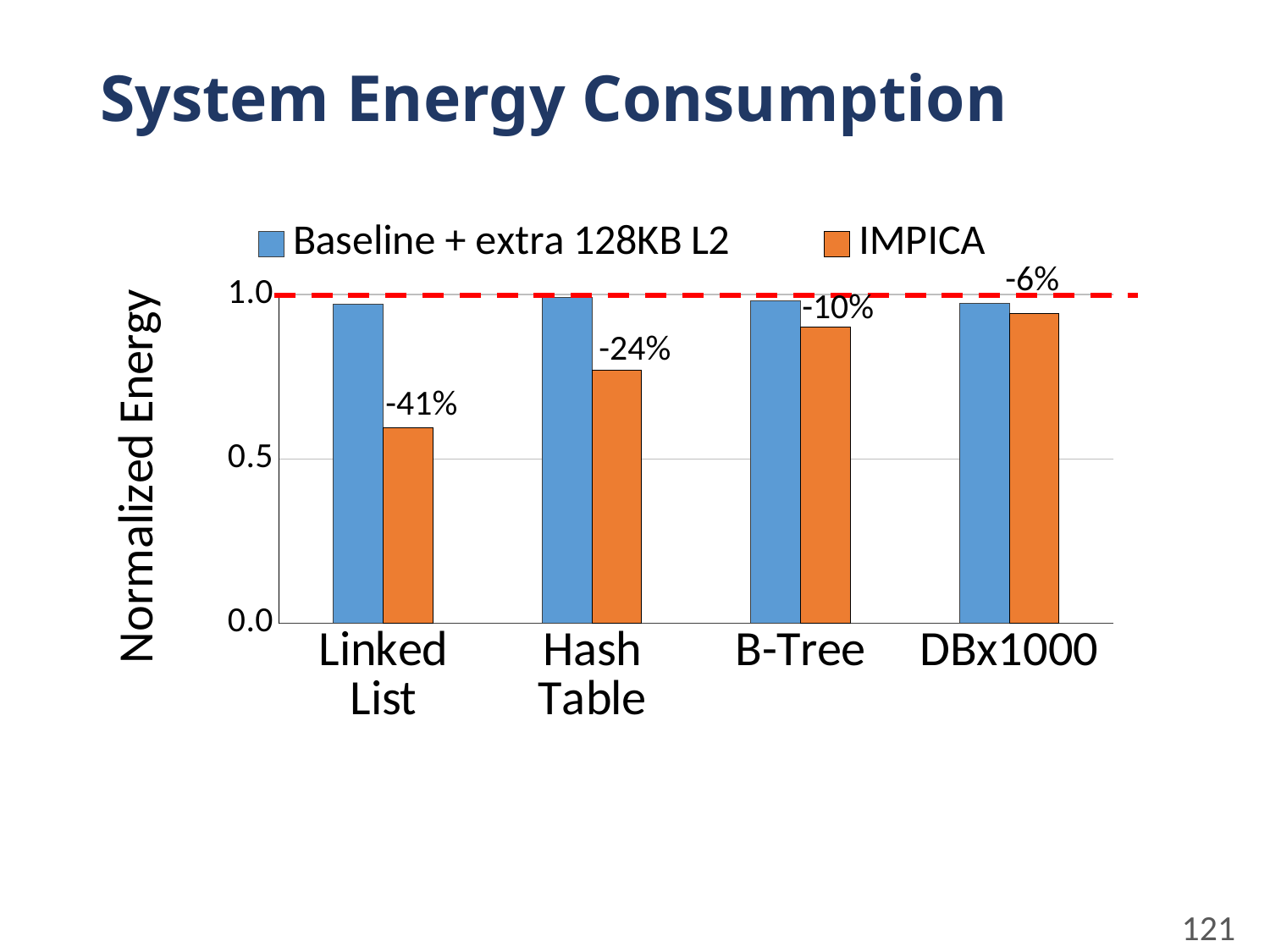
What is the label on the y axis of the chart? Normalized Energy What kind of chart is shown on the slide? bar chart What percentage reduction is labeled above the IMPICA bar for Hash Table? -24% Which is larger for Linked List: the Baseline + extra 128KB L2 bar or the IMPICA bar? Baseline + extra 128KB L2 How many series does the chart's legend list? 2 Which category has the highest IMPICA normalized energy? DBx1000 What percentage reduction is labeled above the IMPICA bar for DBx1000? -6% What percentage reduction is labeled above the IMPICA bar for B-Tree? -10% What percentage reduction is labeled above the IMPICA bar for Linked List? -41% How many categories are shown on the x axis of the chart? 4 Is the IMPICA normalized energy for Linked List greater or less than 0.5? greater Which category has the lowest IMPICA normalized energy? Linked List